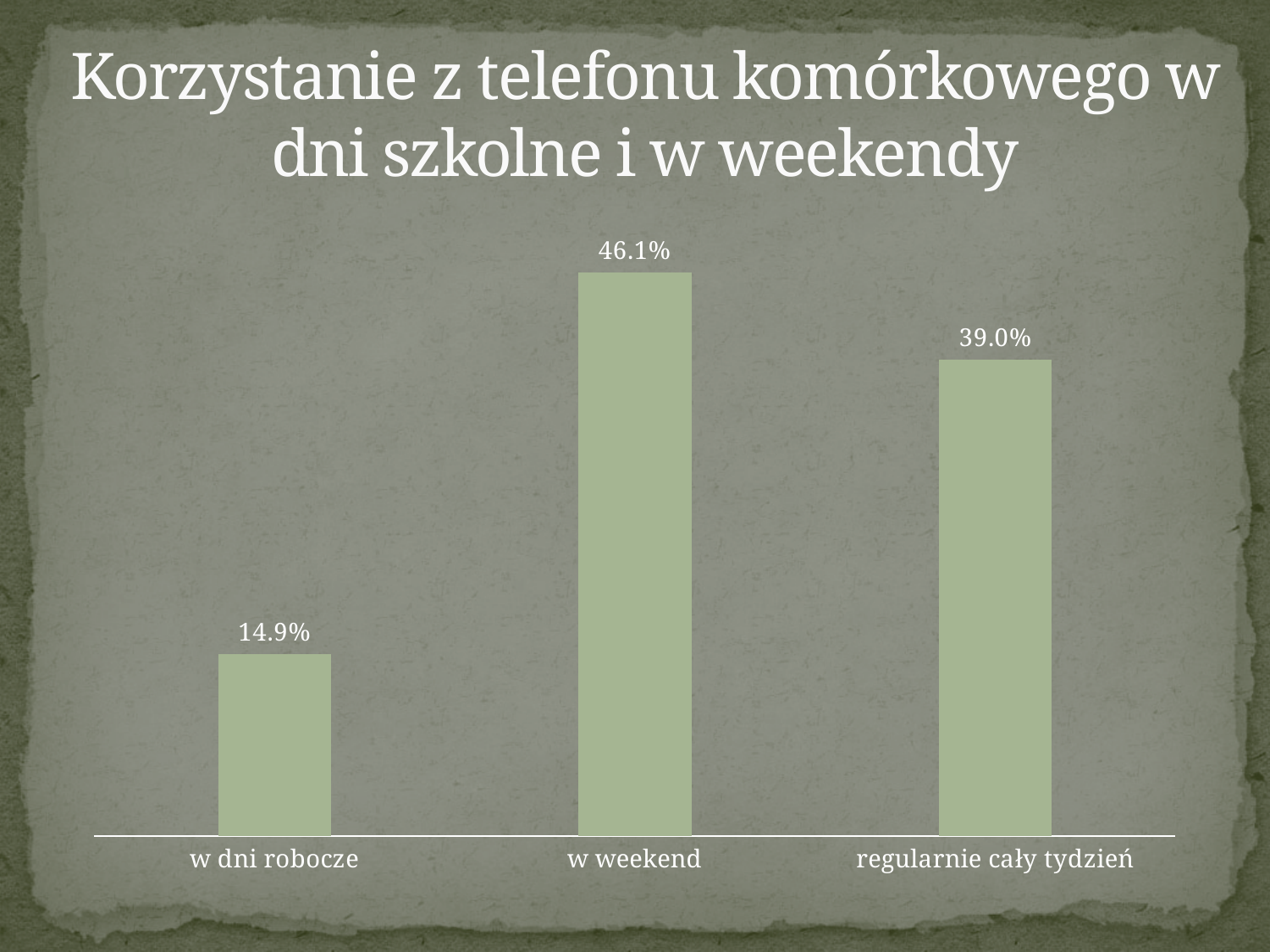
Which category has the highest value? w weekend What is the total of the three values shown in the chart? 100.0% What is the difference between the values for "regularnie cały tydzień" and "w dni robocze"? 24.1% How many categories are shown in the chart? 3 Which is larger, the value for "w dni robocze" or the value for "regularnie cały tydzień"? regularnie cały tydzień What is the value for "w dni robocze"? 14.9% What is the title of the slide? Korzystanie z telefonu komórkowego w dni szkolne i w weekendy Which category has the lowest value? w dni robocze What is the value for "regularnie cały tydzień"? 39.0% What is the value for "w weekend"? 46.1% What kind of chart is shown on the slide? bar chart What is the difference between the values for "w weekend" and "regularnie cały tydzień"? 7.1%